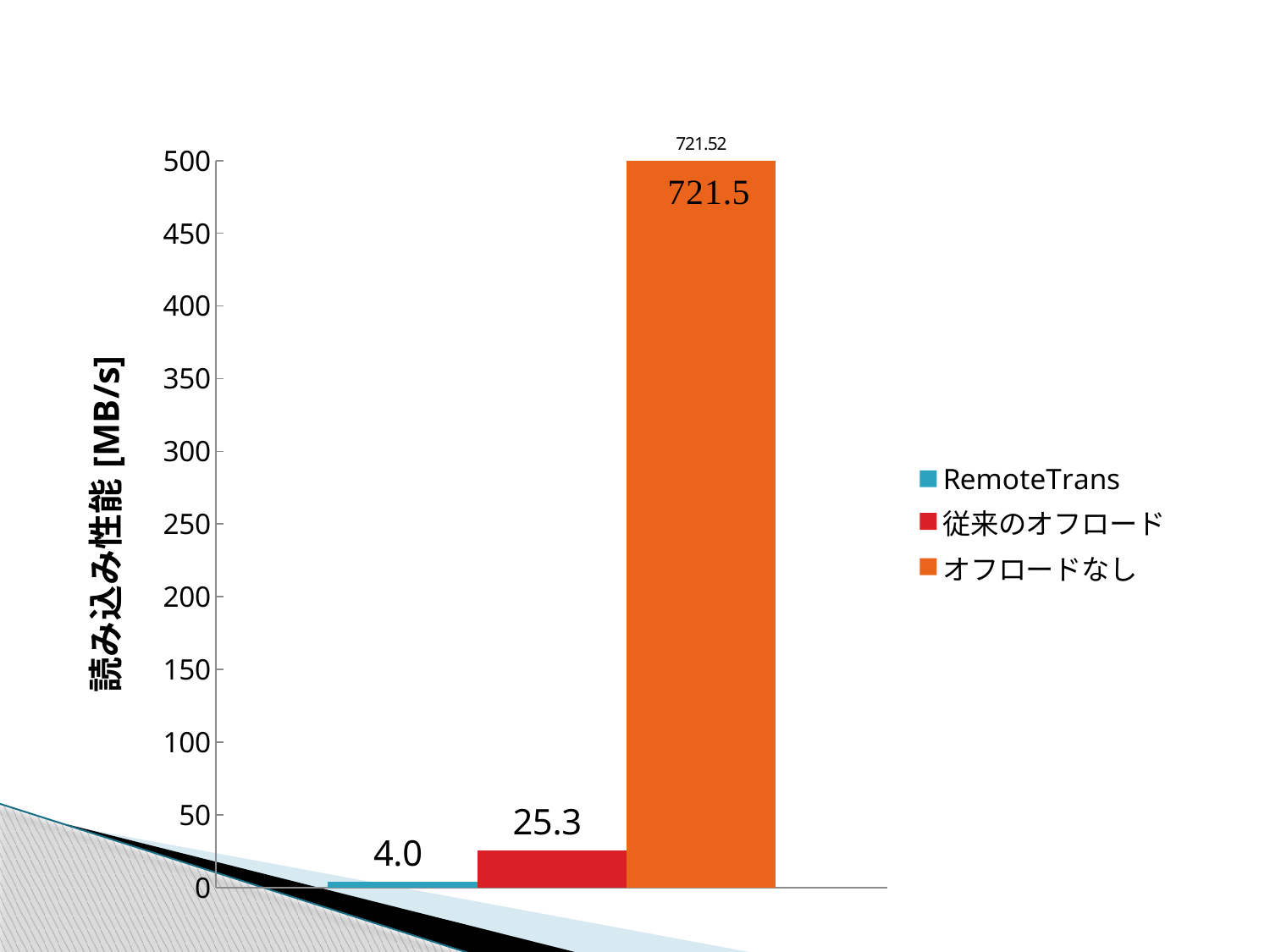
What is the label of the vertical axis? 読み込み性能 [MB/s] Which series has the highest read performance? オフロードなし Which is larger, the value for 従来のオフロード or the value for RemoteTrans? 従来のオフロード What is the difference between the values for 従来のオフロード and RemoteTrans? 21.3 What is the value for 従来のオフロード? 25.3 What is the value for RemoteTrans? 4.0 How many bars are plotted in the chart? 3 Is the value for オフロードなし greater or less than 500? greater Is the value for 従来のオフロード greater or less than 50? less Which series has the lowest read performance? RemoteTrans What kind of chart is shown on the slide? bar chart How many series does the legend list? 3